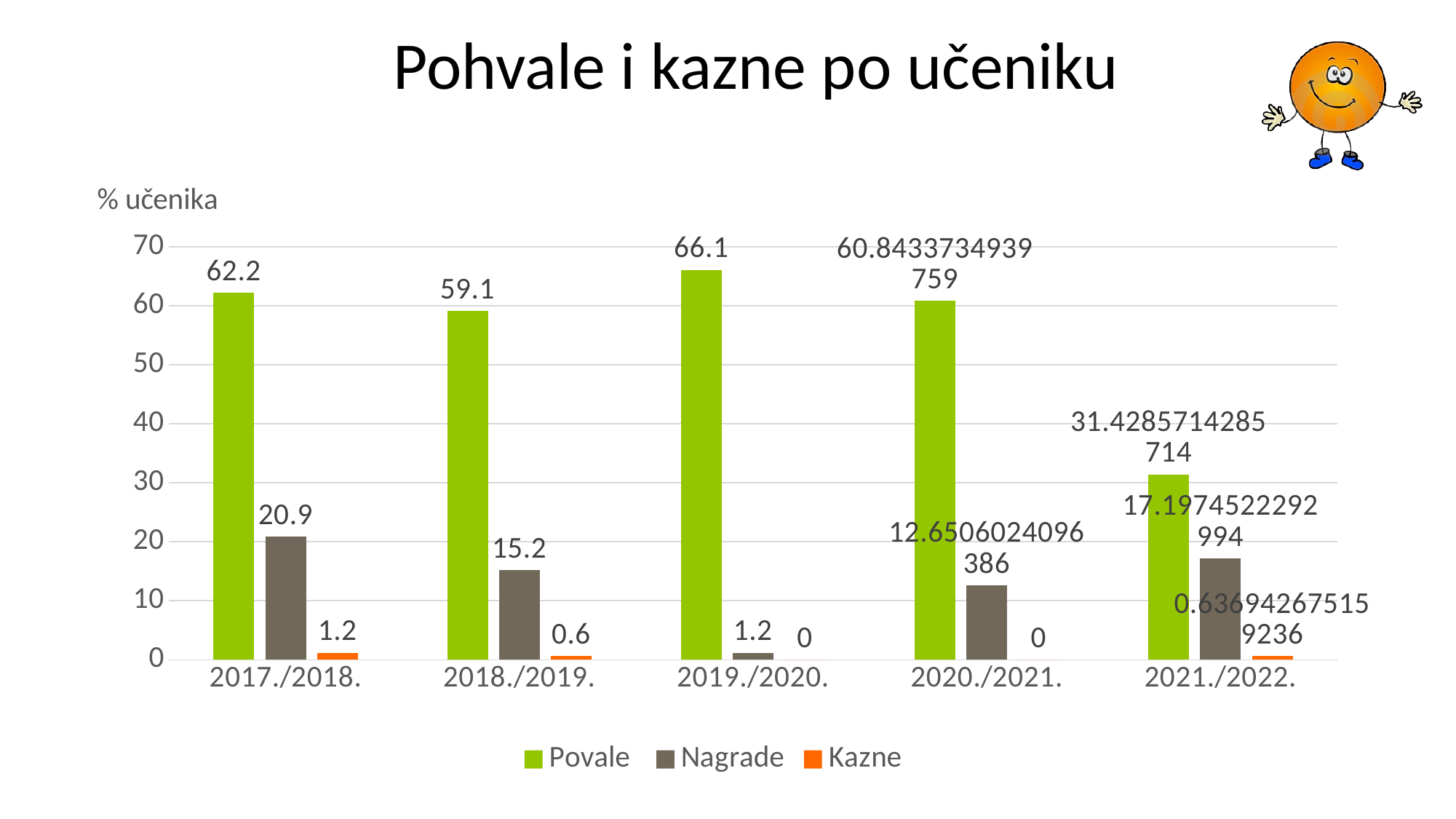
Which is larger, the Nagrade value for 2017./2018. or for 2018./2019.? 2017./2018. What is the value for Povale in 2017./2018.? 62.2 What is the value for Nagrade in 2017./2018.? 20.9 Which school year has the lowest value for Povale? 2021./2022. What kind of chart is shown on the slide? bar chart Which school year has the highest value for Povale? 2019./2020. What is the value for Kazne in 2019./2020.? 0 What is the value for Nagrade in 2018./2019.? 15.2 What is the difference between the Povale values for 2017./2018. and 2018./2019.? 3.1 How many series does the legend list? 3 How many school years are shown on the x axis? 5 Is the value for Povale in 2020./2021. greater or less than 50? greater